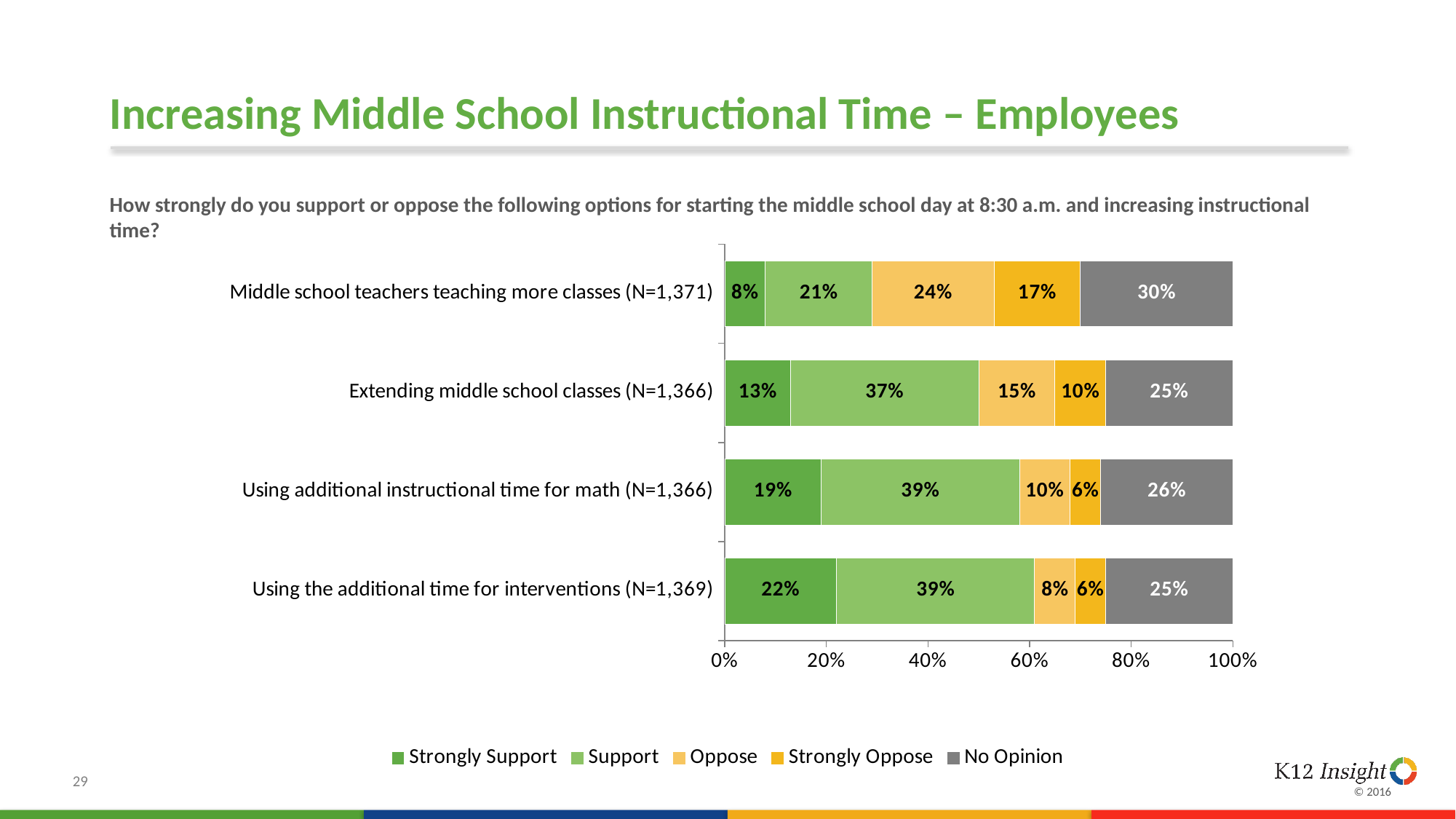
Which option has the highest Strongly Oppose percentage? Middle school teachers teaching more classes (N=1,371) What percentage of employees strongly oppose using additional instructional time for math? 6% What percentage of employees strongly support using the additional time for interventions? 22% What kind of chart is shown on the slide? Stacked bar chart How many series does the legend list? 5 Which is larger: the Strongly Support percentage for extending middle school classes or for using additional instructional time for math? Using additional instructional time for math What percentage of employees have no opinion on middle school teachers teaching more classes? 30% Which option has the lowest Strongly Support percentage? Middle school teachers teaching more classes (N=1,371) What is the combined Strongly Support and Support percentage for using additional instructional time for math? 58% What percentage of employees support extending middle school classes? 37% How many options (categories) are shown in the chart? 4 What is the difference between the Oppose percentage for middle school teachers teaching more classes and the Oppose percentage for using the additional time for interventions? 16%